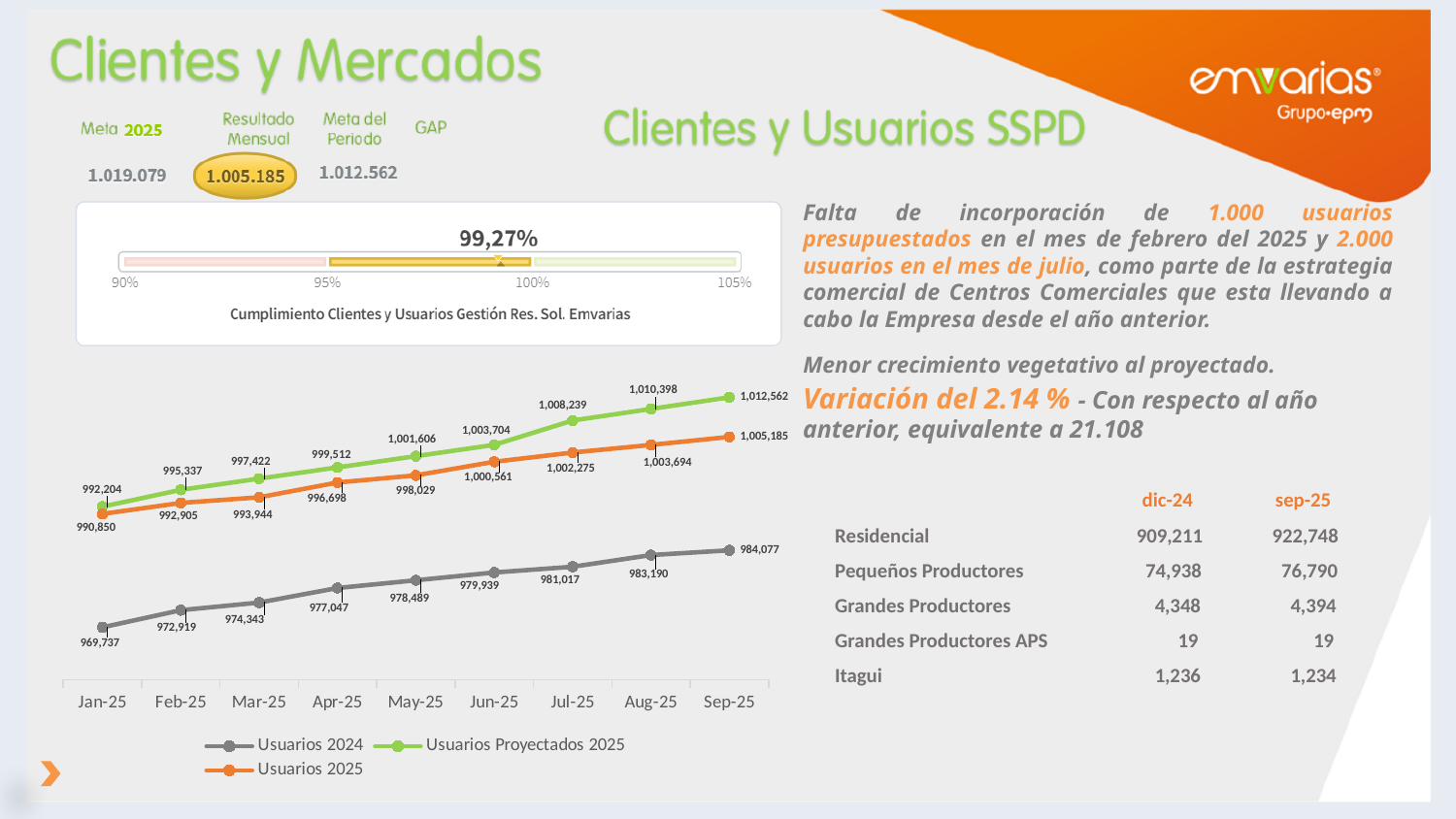
In the line chart at the bottom left, do the values for Usuarios 2025 rise or fall from Jan-25 to Sep-25? Rise How many series does the legend of the line chart at the bottom left list? 3 In the line chart at the bottom left, what is the difference between Usuarios Proyectados 2025 and Usuarios 2025 in Sep-25? 7,377 In the line chart at the bottom left, what is the value for Usuarios 2024 in Jan-25? 969,737 In the line chart at the bottom left, which is larger in May-25: Usuarios 2025 or Usuarios 2024? Usuarios 2025 What percentage is shown on the gauge chart titled 'Cumplimiento Clientes y Usuarios Gestión Res. Sol. Emvarias'? 99,27% In the line chart at the bottom left, what is the value for Usuarios Proyectados 2025 in Jul-25? 1,008,239 In the line chart at the bottom left, which month has the lowest value for Usuarios Proyectados 2025? Jan-25 In the line chart at the bottom left, which month has the highest value for Usuarios 2024? Sep-25 In the line chart at the bottom left, what is the value for Usuarios 2025 in Sep-25? 1,005,185 What kind of chart is shown at the bottom left of the slide? Line chart How many months are shown on the x axis of the line chart at the bottom left? 9